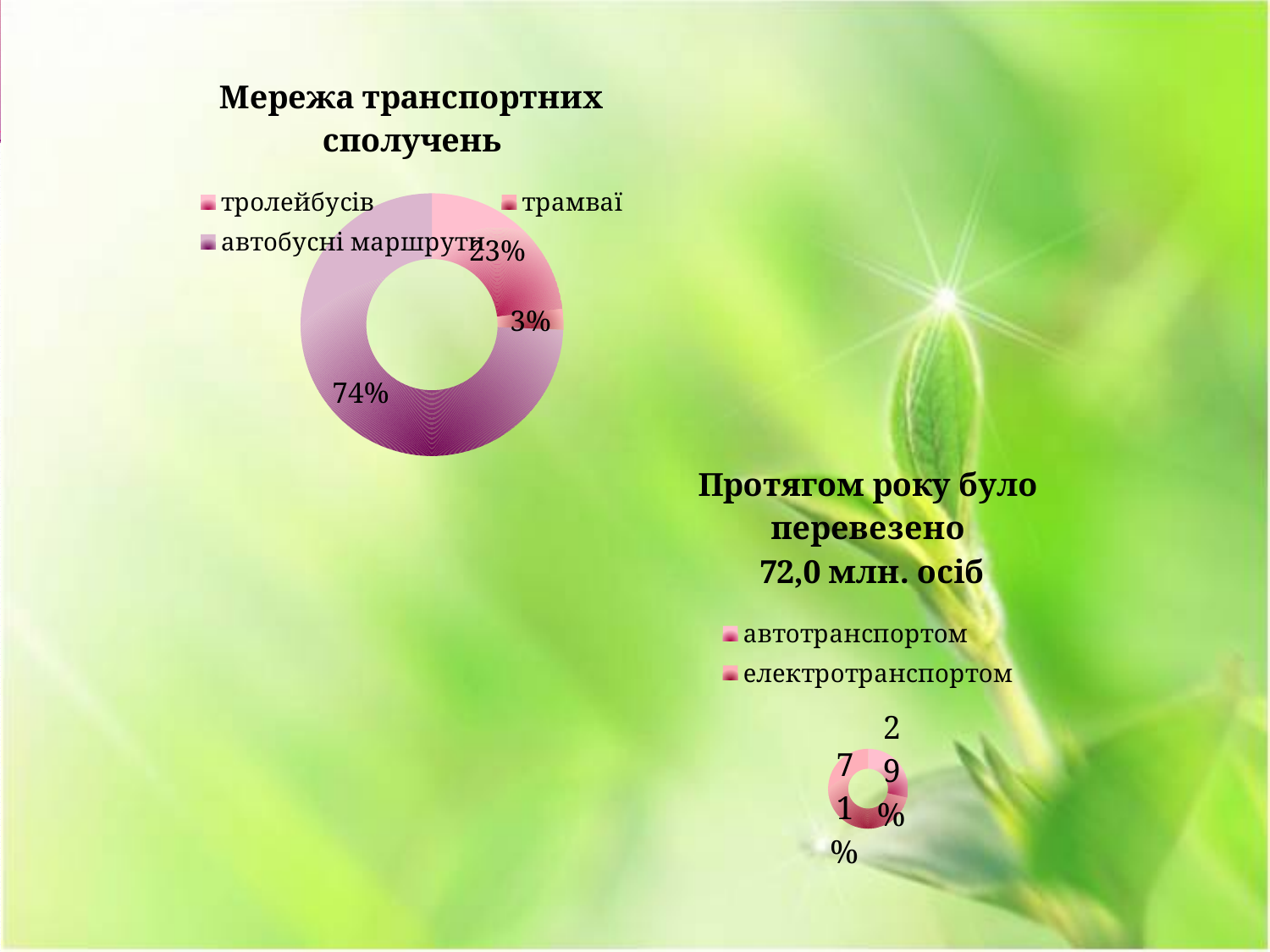
In the chart titled "Протягом року було перевезено 72,0 млн. осіб", which category has the larger share? електротранспортом In the chart titled "Протягом року було перевезено 72,0 млн. осіб", what share is labelled for автотранспортом? 29% In the chart titled "Протягом року було перевезено 72,0 млн. осіб", how many categories does the legend list? 2 In the chart titled "Мережа транспортних сполучень", what is the difference in percentage points between автобусні маршрути and тролейбусів? 51 In the chart titled "Мережа транспортних сполучень", how many categories does the legend list? 3 In the chart titled "Мережа транспортних сполучень", what share is labelled for трамваї? 3% In the chart titled "Мережа транспортних сполучень", what share is labelled for тролейбусів? 23% In the chart titled "Мережа транспортних сполучень", which category has the largest share? автобусні маршрути In the chart titled "Мережа транспортних сполучень", what share is labelled for автобусні маршрути? 74% What kind of chart is the one titled "Мережа транспортних сполучень"? doughnut chart In the chart titled "Мережа транспортних сполучень", which category has the smallest share? трамваї In the chart titled "Протягом року було перевезено 72,0 млн. осіб", what share is labelled for електротранспортом? 71%